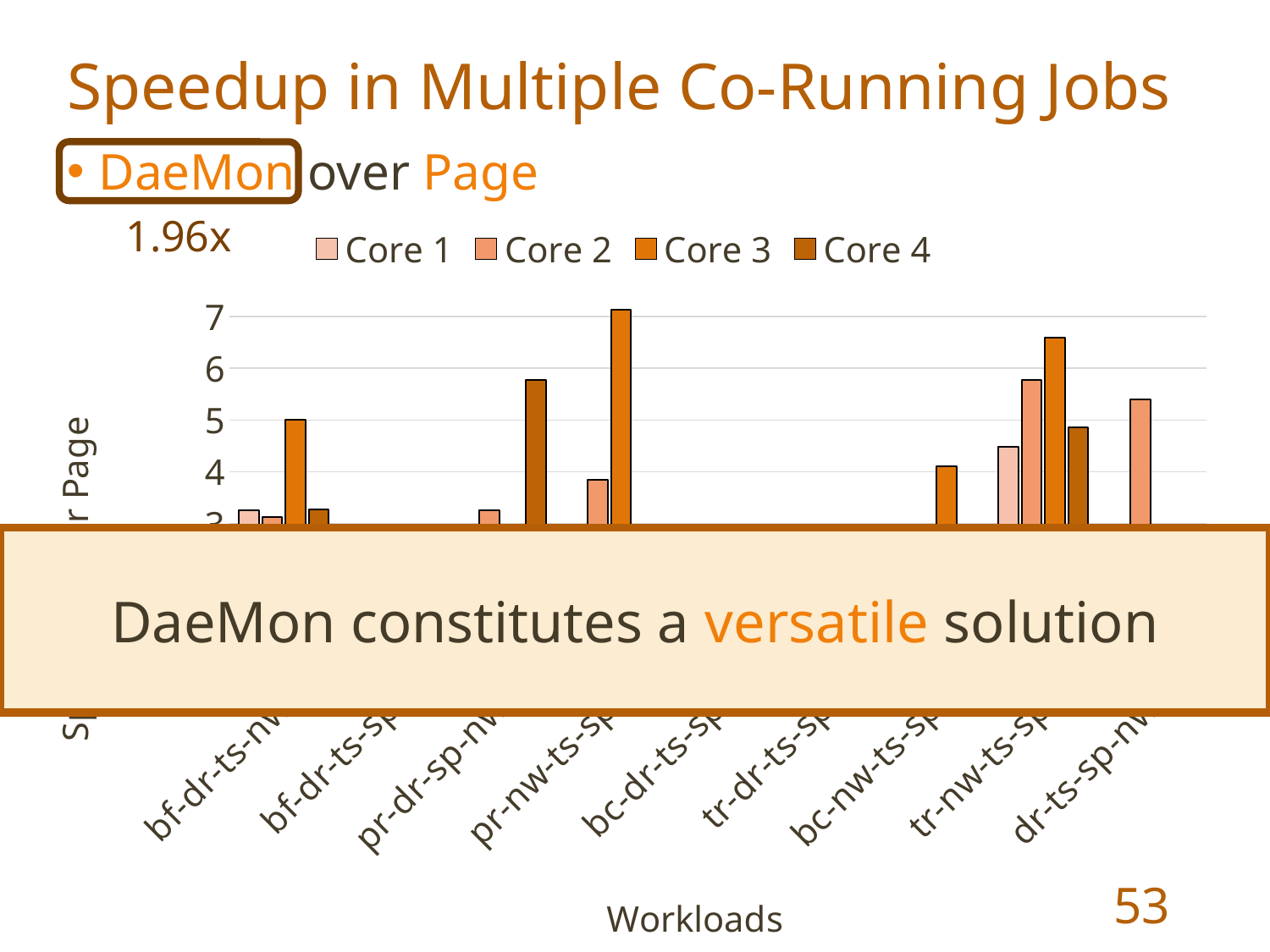
What kind of chart is shown on the slide? bar chart For tr-nw-ts-sp, which is larger: the Core 3 value or the Core 4 value? Core 3 How many series does the legend list? 4 How many workload categories are shown on the x axis? 9 Is the Core 4 value for pr-dr-sp-nw greater or less than 5? greater What is the title of the x axis? Workloads Which series are listed in the legend? Core 1, Core 2, Core 3, Core 4 Is the Core 2 value for dr-ts-sp-nw greater or less than 5? greater Which workload has the tallest bar in the chart? pr-nw-ts-sp For tr-nw-ts-sp, which is larger: the Core 1 value or the Core 2 value? Core 2 Is the Core 3 value for tr-nw-ts-sp greater or less than 6? greater